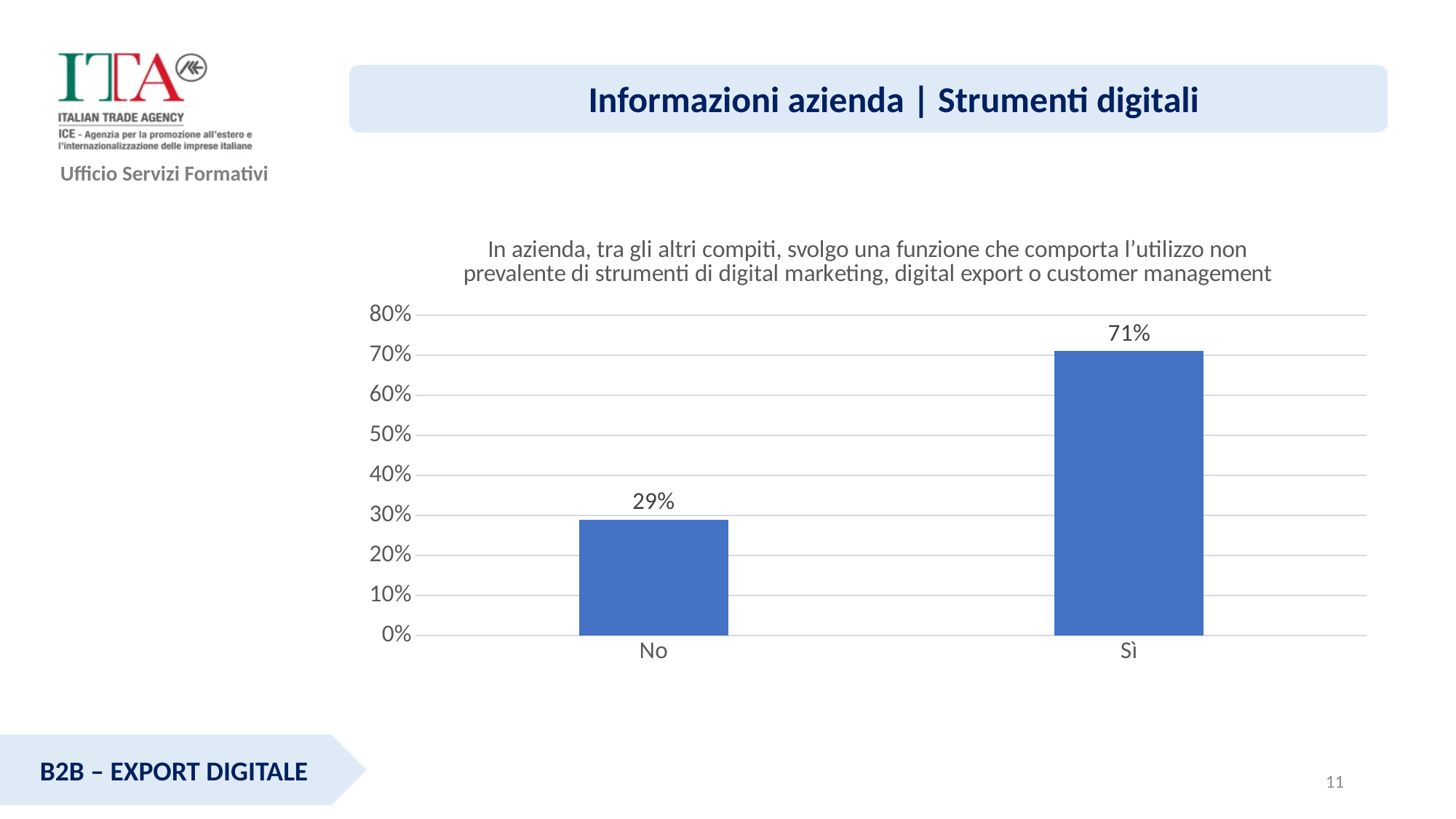
What is the difference between the values for "Sì" and "No"? 42% What colour are the bars in the chart? Blue What is the value for "No"? 29% Which category has the highest value? Sì What is the value for "Sì"? 71% How many categories are shown on the x axis? 2 What is the highest value shown on the y axis? 80% Is the value for "No" greater or less than 40%? less What kind of chart is shown on the slide? Bar chart Which is larger, the value for "No" or the value for "Sì"? Sì Which category has the lowest value? No Is the value for "Sì" greater or less than 50%? greater